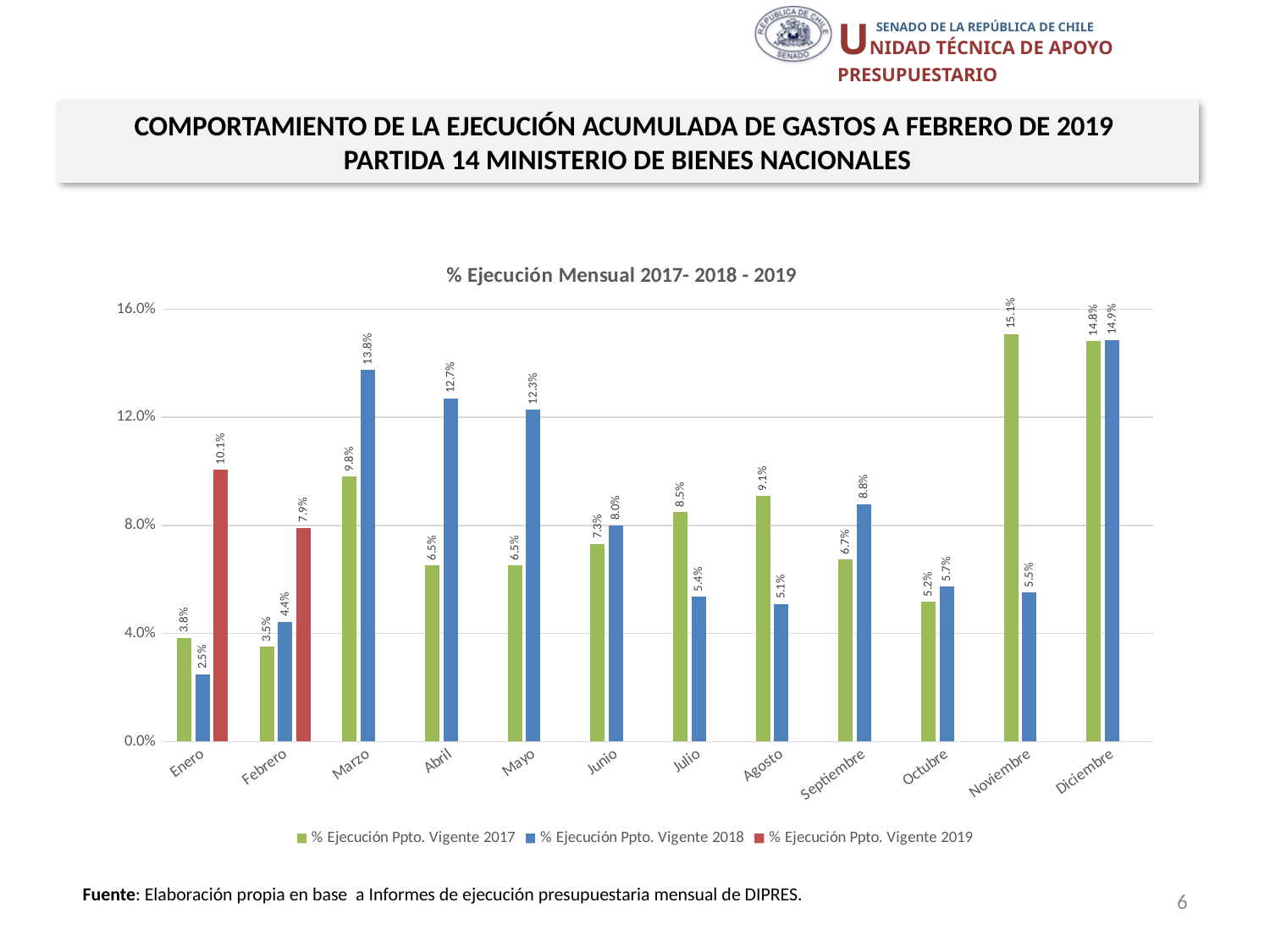
What is the difference between the 2019 and 2018 values for Febrero? 3.5% Is the value of % Ejecución Ppto. Vigente 2018 for Abril greater or less than 12.0%? greater Which month has the highest value for % Ejecución Ppto. Vigente 2017? Noviembre What is the title of the chart? % Ejecución Mensual 2017- 2018 - 2019 How many series does the legend list? 3 What is the value of % Ejecución Ppto. Vigente 2018 for Marzo? 13.8% Which is larger in Julio: the 2017 value or the 2018 value? 2017 value (8.5%) Which month has the lowest value for % Ejecución Ppto. Vigente 2018? Enero What is the value of % Ejecución Ppto. Vigente 2017 for Agosto? 9.1% What kind of chart is shown on the slide? Bar chart How many months are shown on the x axis? 12 What is the value of % Ejecución Ppto. Vigente 2019 for Enero? 10.1%